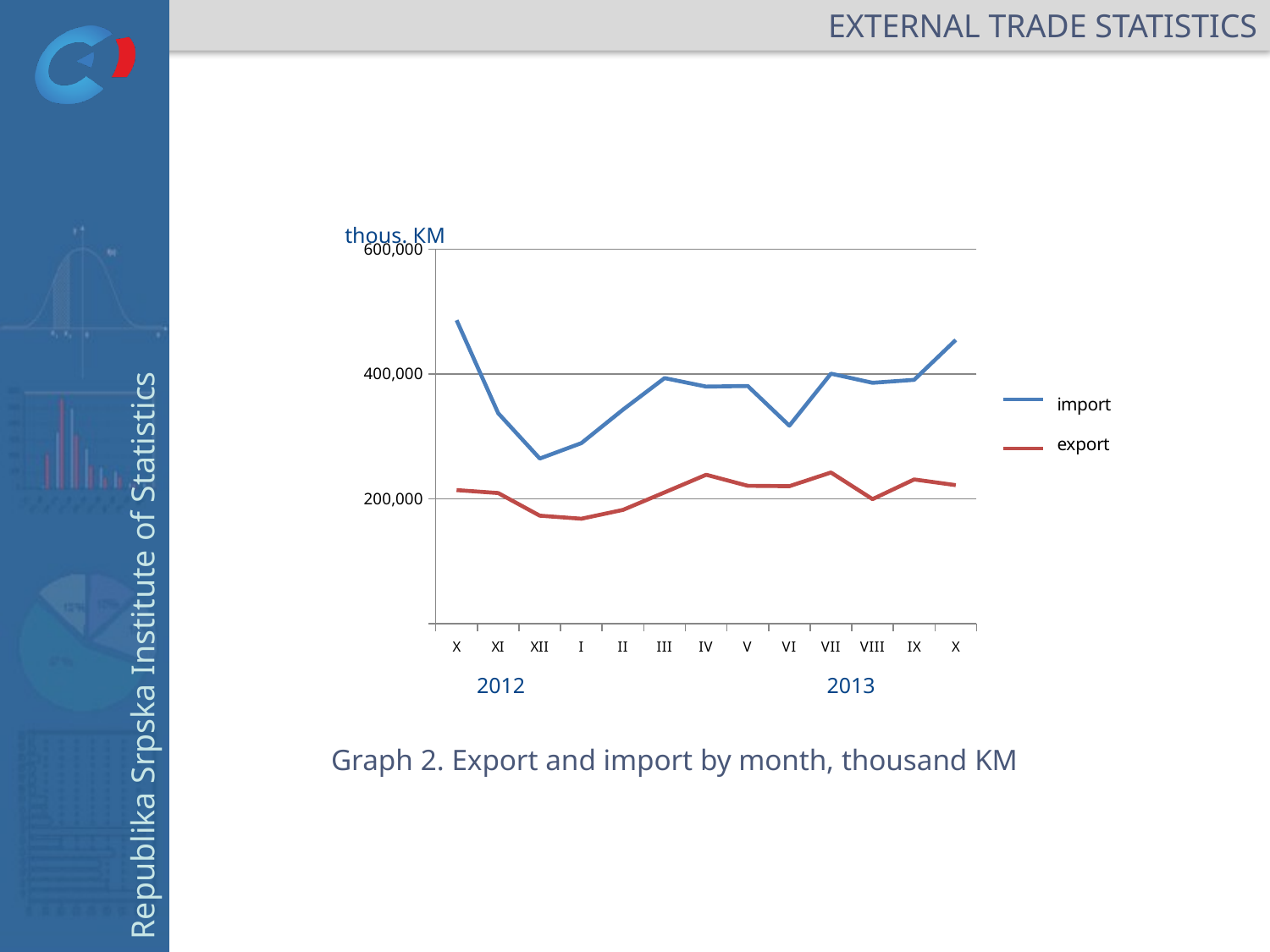
What kind of chart is shown on the slide? line chart Is the import value for X 2012 greater or less than 400,000? greater In which month is the import value lowest? XII 2012 In which month is the import value highest? X 2012 Is the export value for VII 2013 greater or less than 400,000? less How many series does the legend list? 2 Is the import value for XII 2012 greater or less than 400,000? less Does the import value rise or fall from X 2012 to XII 2012? fall Which is larger in VI 2013, import or export? import What colour is the export line? red How many months are plotted along the x axis? 13